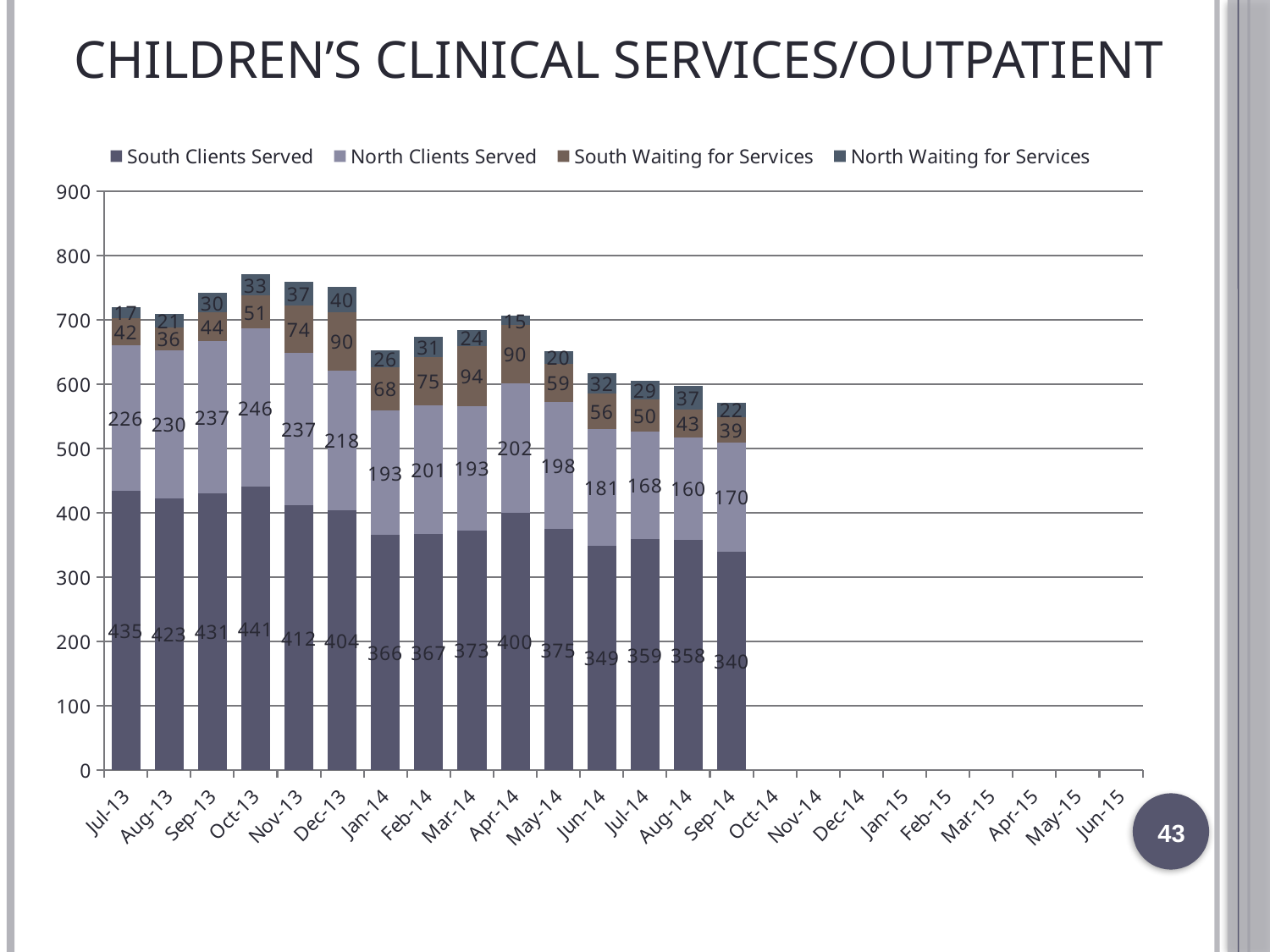
What is the difference between South Clients Served in Jul-13 and Sep-14? 95 What type of chart is shown on the slide? Stacked bar chart What is the total of the stacked bar for Oct-13? 771 What is the value of North Clients Served for Dec-13? 218 How many series does the legend list? 4 Which month has the lowest value for South Clients Served? Sep-14 Does the value of South Clients Served generally rise or fall from Jul-13 to Sep-14? Fall What is the value of North Waiting for Services for Sep-14? 22 What is the value of South Waiting for Services for Mar-14? 94 Which month has the highest value for South Clients Served? Oct-13 What is the value of South Clients Served for Oct-13? 441 Which is larger, North Clients Served in Apr-14 or in May-14? Apr-14